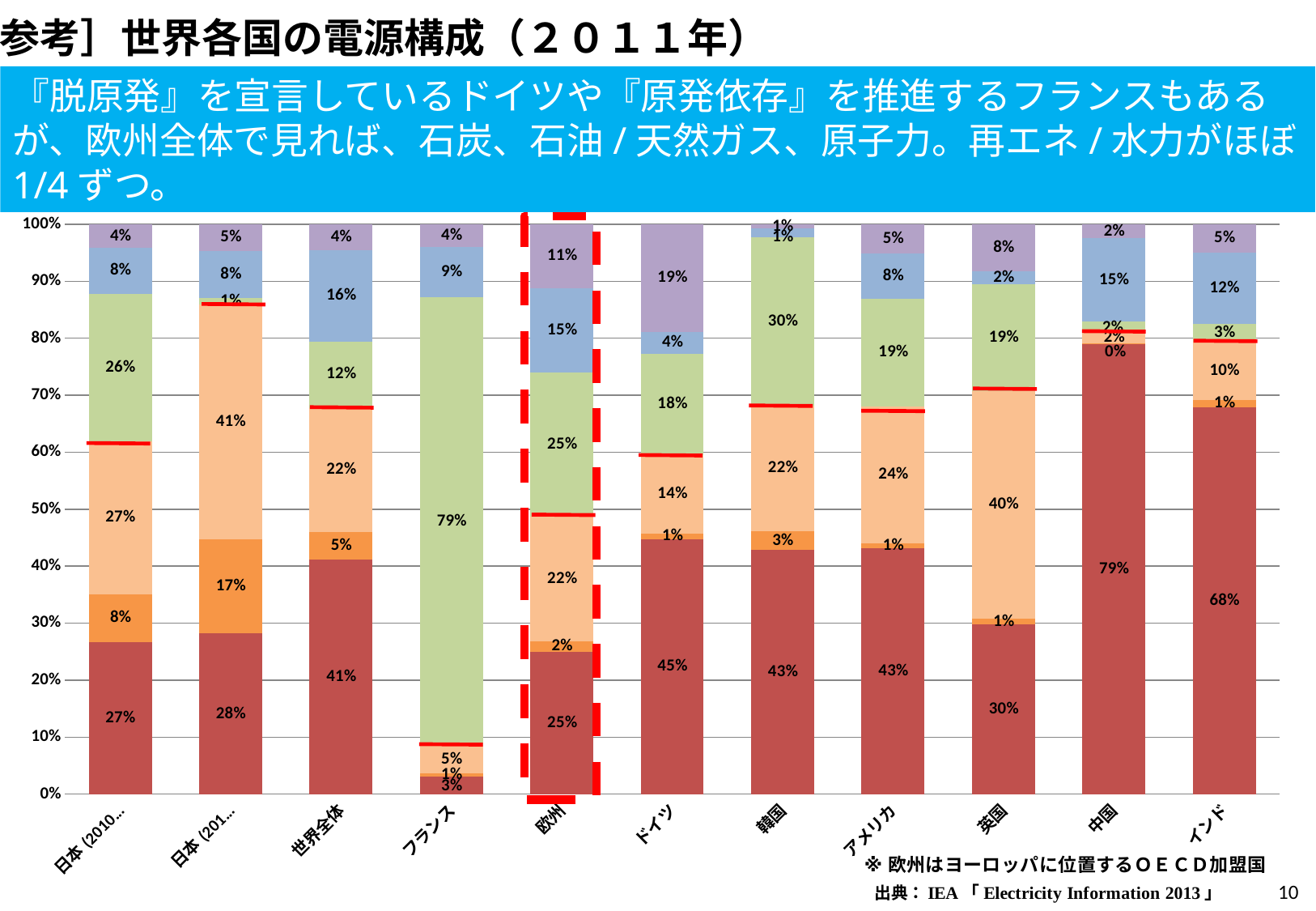
What is the value of the green segment for フランス? 79% What is the title of the slide containing the chart? 参考］世界各国の電源構成（２０１１年） Which country or region has the smallest bottom (dark red) segment? フランス Which country or region has the largest bottom (dark red) segment? 中国 What is the value of the top (purple) segment for ドイツ? 19% What kind of chart is shown on the slide? stacked bar chart How many countries or regions are shown along the x axis of the chart? 11 What is the value of the bottom (dark red) segment for 欧州? 25% What is the difference between the bottom (dark red) segment values of 中国 and インド? 11% Which has a larger bottom (dark red) segment, ドイツ or 韓国? ドイツ What is the value of the light orange segment for 英国? 40% What is the value of the bottom (dark red) segment for 中国? 79%